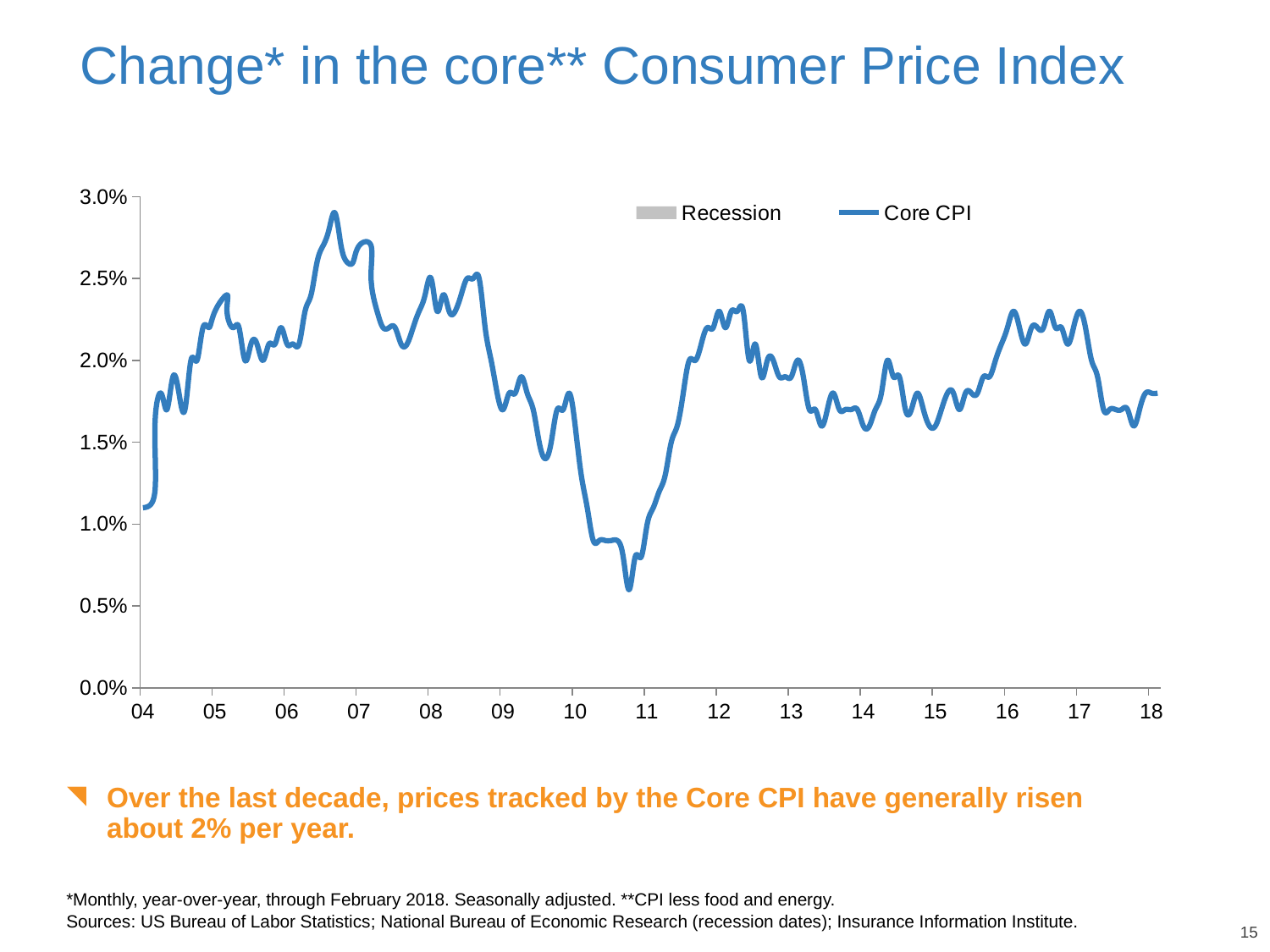
What kind of chart is shown on the slide? line chart What are the two entries in the chart's legend? Recession and Core CPI How many year labels are shown on the x axis? 15 Between the 09 tick and the low point before the 11 tick, does the Core CPI line rise or fall? fall How many series does the legend list? 2 Between the 11 tick and the 12 tick, does the Core CPI line rise or fall? rise What is the title of the chart on the slide? Change* in the core** Consumer Price Index Is the highest point of the Core CPI line, reached between 06 and 07, greater or less than 2.5%? greater Is the Core CPI value at the 18 tick greater or less than 1.5%? greater Is the Core CPI value at the 16 tick greater or less than 2.0%? greater